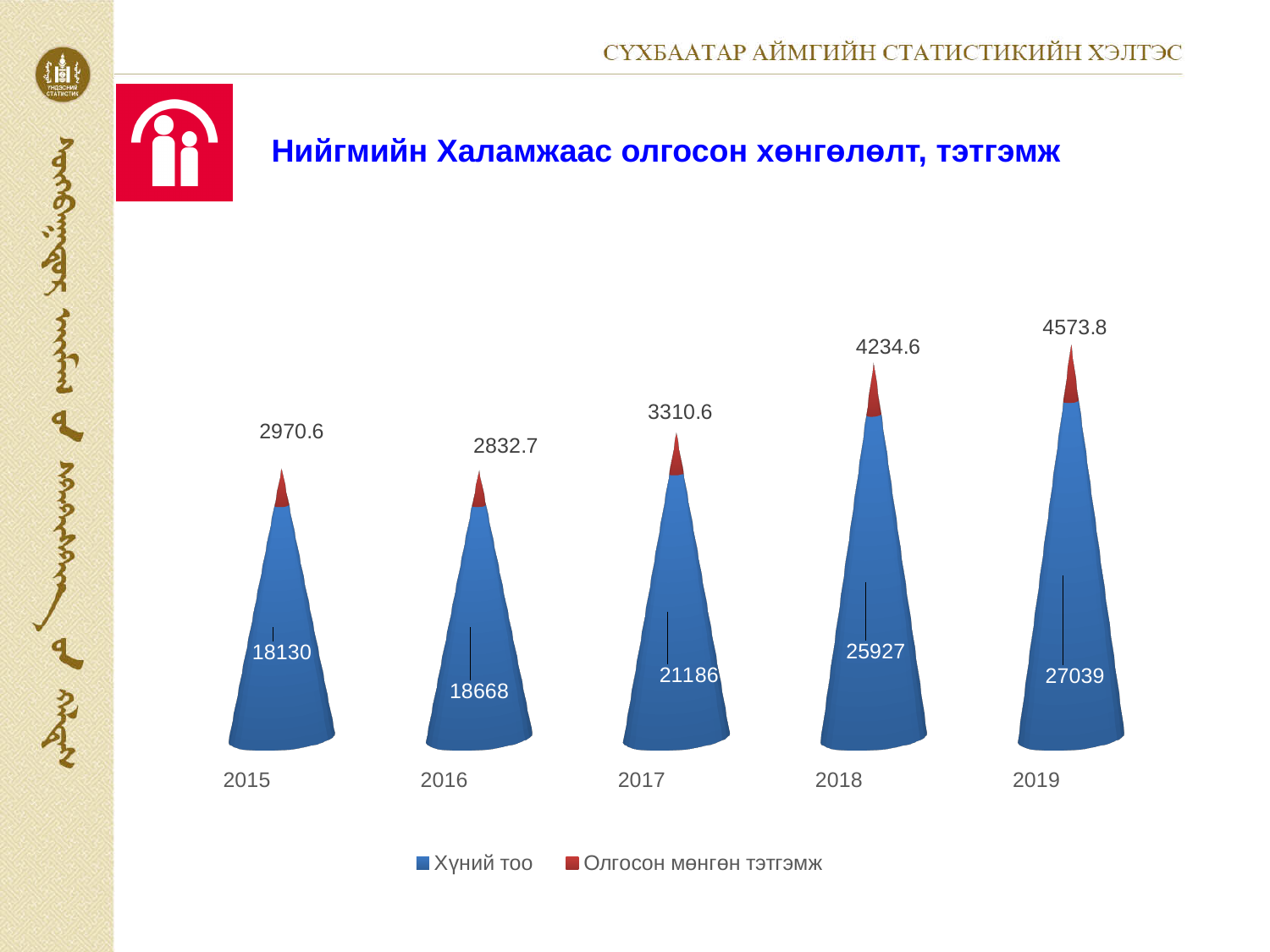
Which year has the highest value of Хүний тоо? 2019 What kind of chart is shown on the slide? Bar chart What is the value of Хүний тоо for 2015? 18130 What is the value of Олгосон мөнгөн тэтгэмж for 2016? 2832.7 How many series does the legend list? 2 What is the value of Хүний тоо for 2017? 21186 Which is larger, the Олгосон мөнгөн тэтгэмж value for 2018 or for 2017? 2018 What is the difference between the Хүний тоо values for 2019 and 2015? 8909 Which year has the lowest value of Олгосон мөнгөн тэтгэмж? 2016 What is the value of Олгосон мөнгөн тэтгэмж for 2019? 4573.8 How many years are shown on the x axis? 5 What is the total of the stacked bar for 2019? 31612.8